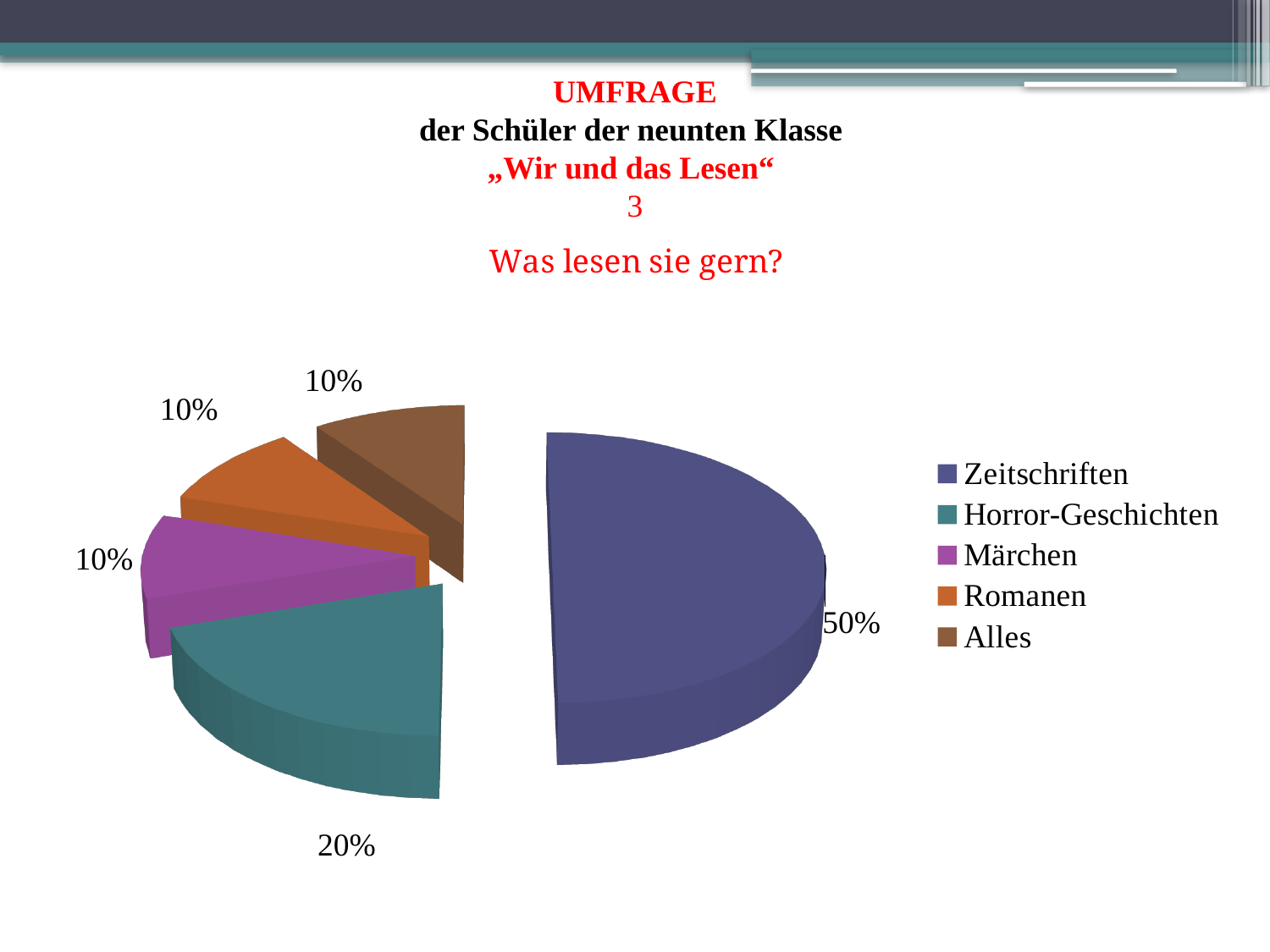
Which is larger, the share for Horror-Geschichten or the share for Märchen? Horror-Geschichten What share of the pie does Horror-Geschichten have? 20% What share of the pie does Zeitschriften have? 50% What is the value shown for Romanen? 10% Which category has the largest slice of the pie? Zeitschriften What question does the chart answer, according to the heading above it? Was lesen sie gern? What is the difference between the shares for Zeitschriften and Horror-Geschichten? 30% What is the value shown for Alles? 10% What is the value shown for Märchen? 10% Which legend entry is shown in orange? Romanen What kind of chart is shown on the slide? Pie chart How many categories does the pie chart show? 5